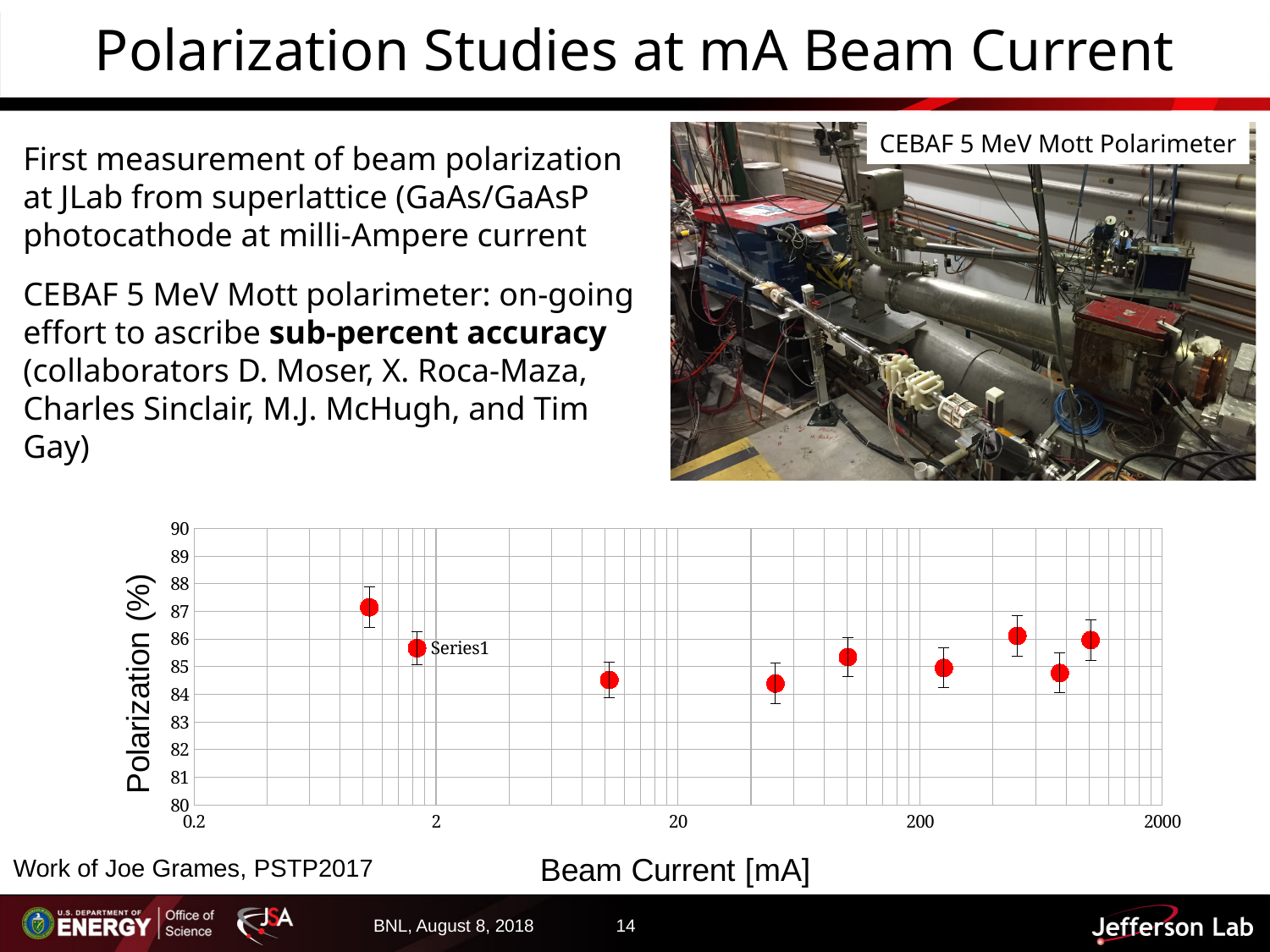
Does the polarization rise or fall between the first two data points (from about 1 mA to about 2 mA)? fall What is the label of the series shown in the chart? Series1 How many data points are plotted in the Polarization vs Beam Current chart? 9 Which data point has the highest polarization value in the chart? the leftmost point (lowest beam current, near 1 mA) Is the polarization of the data point near 10 mA greater or less than 85%? less Which has the higher polarization: the point near 1 mA or the point near 1000 mA? the point near 1 mA Are all plotted polarization values greater or less than 84%? greater Are all plotted polarization values greater or less than 88%? less What kind of chart is shown at the bottom of the slide? scatter plot What is the title of the x axis of the chart? Beam Current [mA]